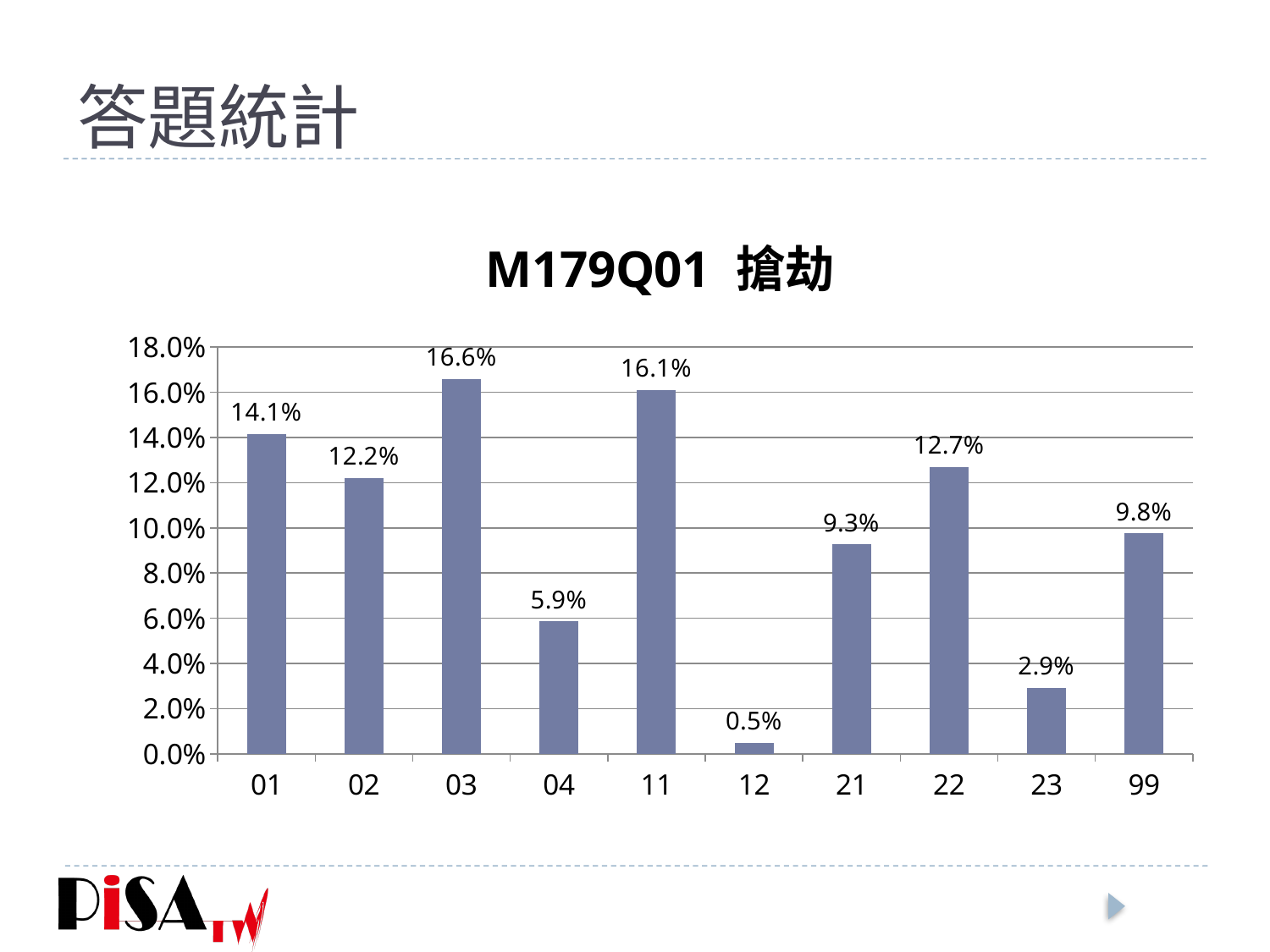
Which is larger, the value for 22 or the value for 21? 22 What is the value for category 12? 0.5% Which category has the highest value? 03 What is the difference between the values for 01 and 02? 1.9% How many categories are shown on the x axis? 10 What is the difference between the values for 03 and 11? 0.5% Which category has the lowest value? 12 What is the value for category 03? 16.6% What kind of chart is shown on the slide? bar chart What is the value for category 99? 9.8% Is the value for 04 greater or less than 8.0%? less What is the title of the chart? M179Q01 搶劫